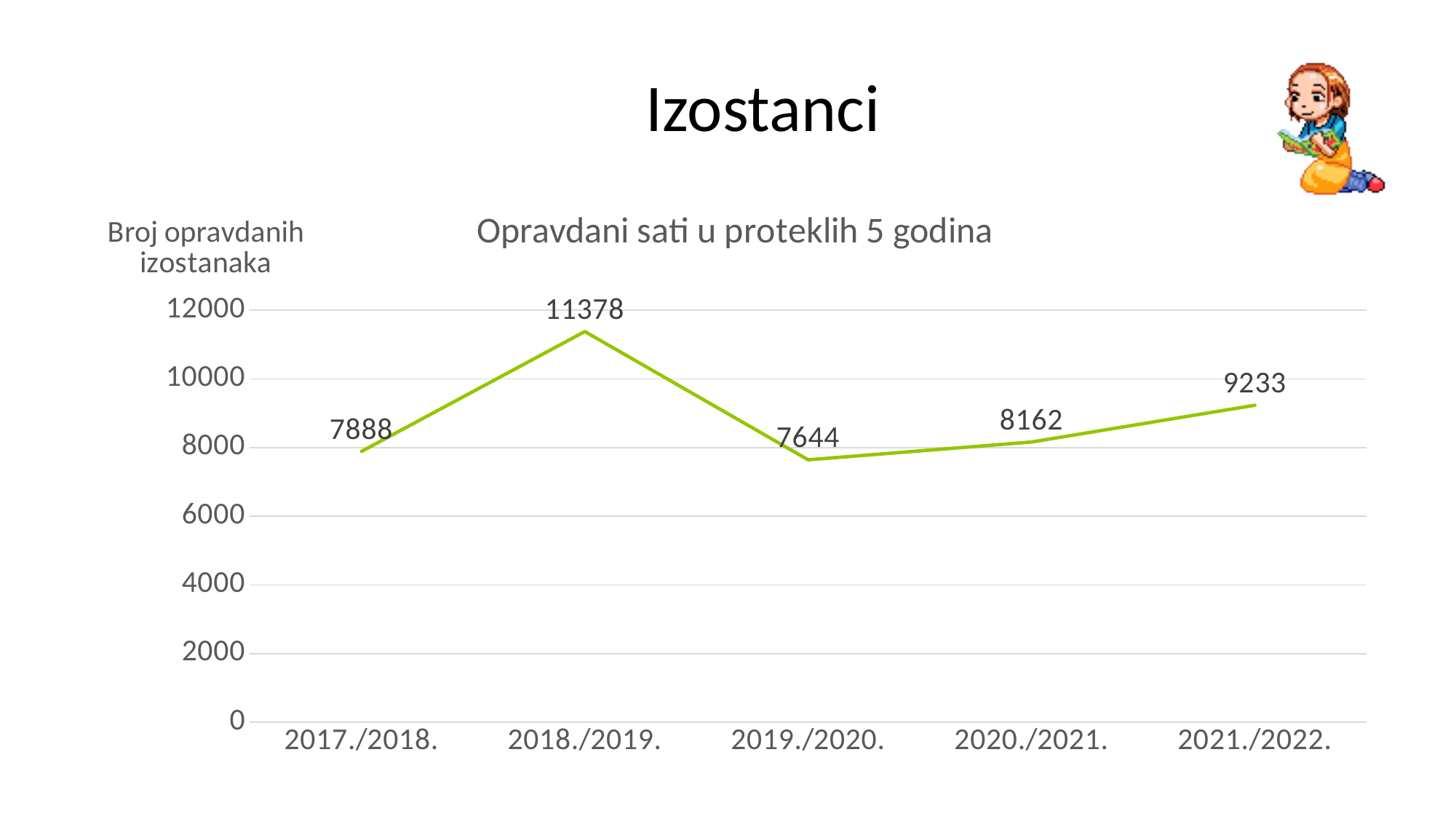
Which school year has the lowest value? 2019./2020. How many school years are plotted on the chart? 5 What is the title of the chart? Opravdani sati u proteklih 5 godina Which school year has the highest value? 2018./2019. What is the value for 2021./2022.? 9233 What is the value for 2018./2019.? 11378 What is the value for 2017./2018.? 7888 Which is larger, the value for 2017./2018. or the value for 2020./2021.? 2020./2021. What kind of chart is shown on the slide? line chart Is the value for 2019./2020. greater or less than 8000? less What is the difference between the values for 2021./2022. and 2020./2021.? 1071 What is the difference between the values for 2018./2019. and 2019./2020.? 3734